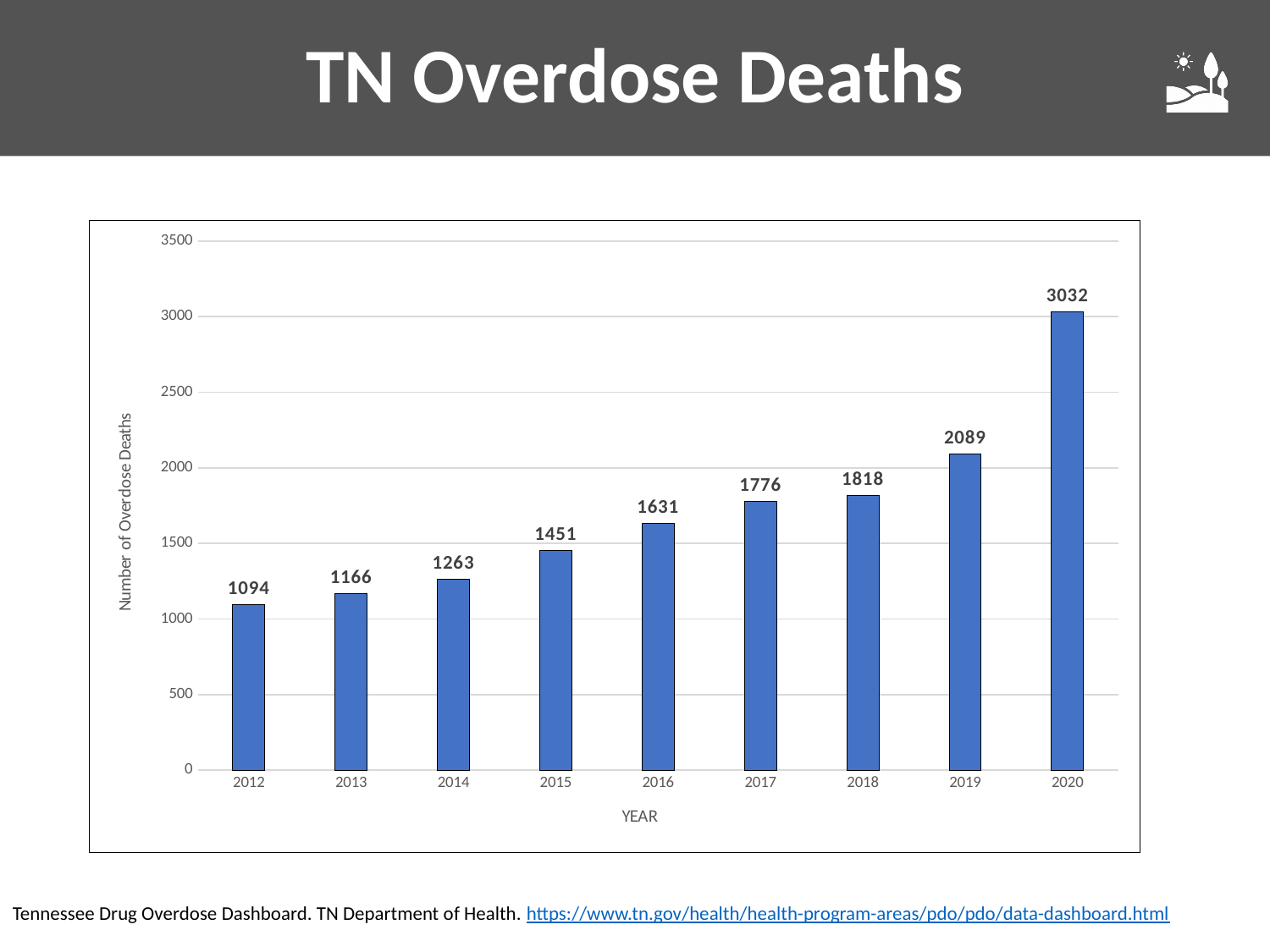
Which year has the highest number of overdose deaths? 2020 How many years are shown on the x axis? 9 Which year had more overdose deaths, 2014 or 2015? 2015 What is the number of overdose deaths for 2016? 1631 What is the difference in overdose deaths between 2018 and 2017? 42 What is the number of overdose deaths for 2012? 1094 Do overdose deaths rise or fall from 2012 to 2020? Rise Is the value for 2019 greater or less than 2000? greater What kind of chart is shown on the slide? Bar chart What is the number of overdose deaths for 2019? 2089 What is the difference in overdose deaths between 2020 and 2019? 943 Which year has the lowest number of overdose deaths? 2012